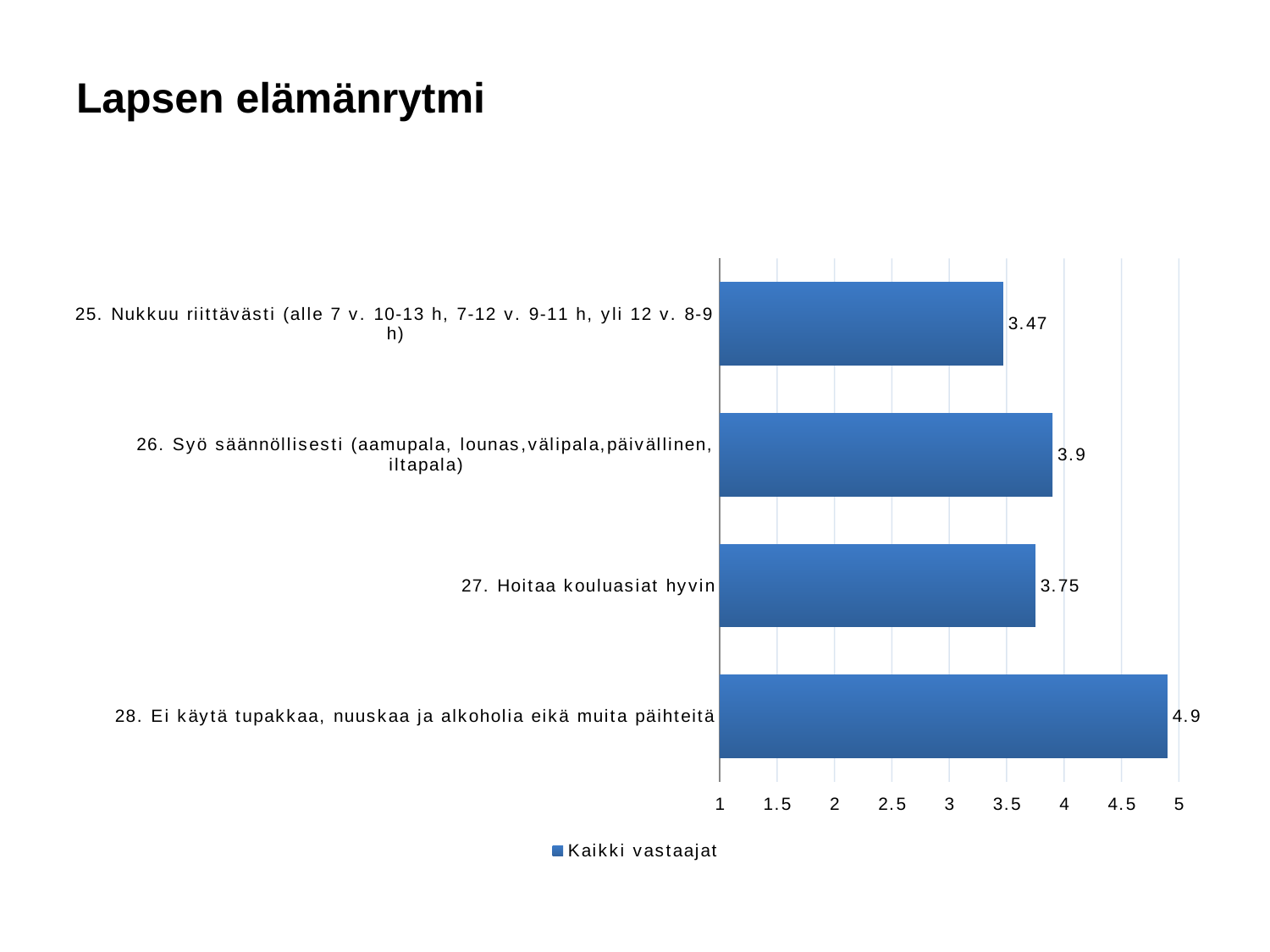
What is the value for '26. Syö säännöllisesti'? 3.9 What is the value for '28. Ei käytä tupakkaa, nuuskaa ja alkoholia eikä muita päihteitä'? 4.9 What is the difference between the values for item 26 and item 27? 0.15 Which is larger, the value for item 26 or the value for item 27? Item 26 (3.9) Which category has the highest value? 28. Ei käytä tupakkaa, nuuskaa ja alkoholia eikä muita päihteitä What series does the legend list? Kaikki vastaajat What is the value for '27. Hoitaa kouluasiat hyvin'? 3.75 What is the value for '25. Nukkuu riittävästi'? 3.47 What type of chart is shown on the slide? Bar chart How many categories are shown in the chart? 4 Which category has the lowest value? 25. Nukkuu riittävästi What is the difference between the values for item 28 and item 25? 1.43